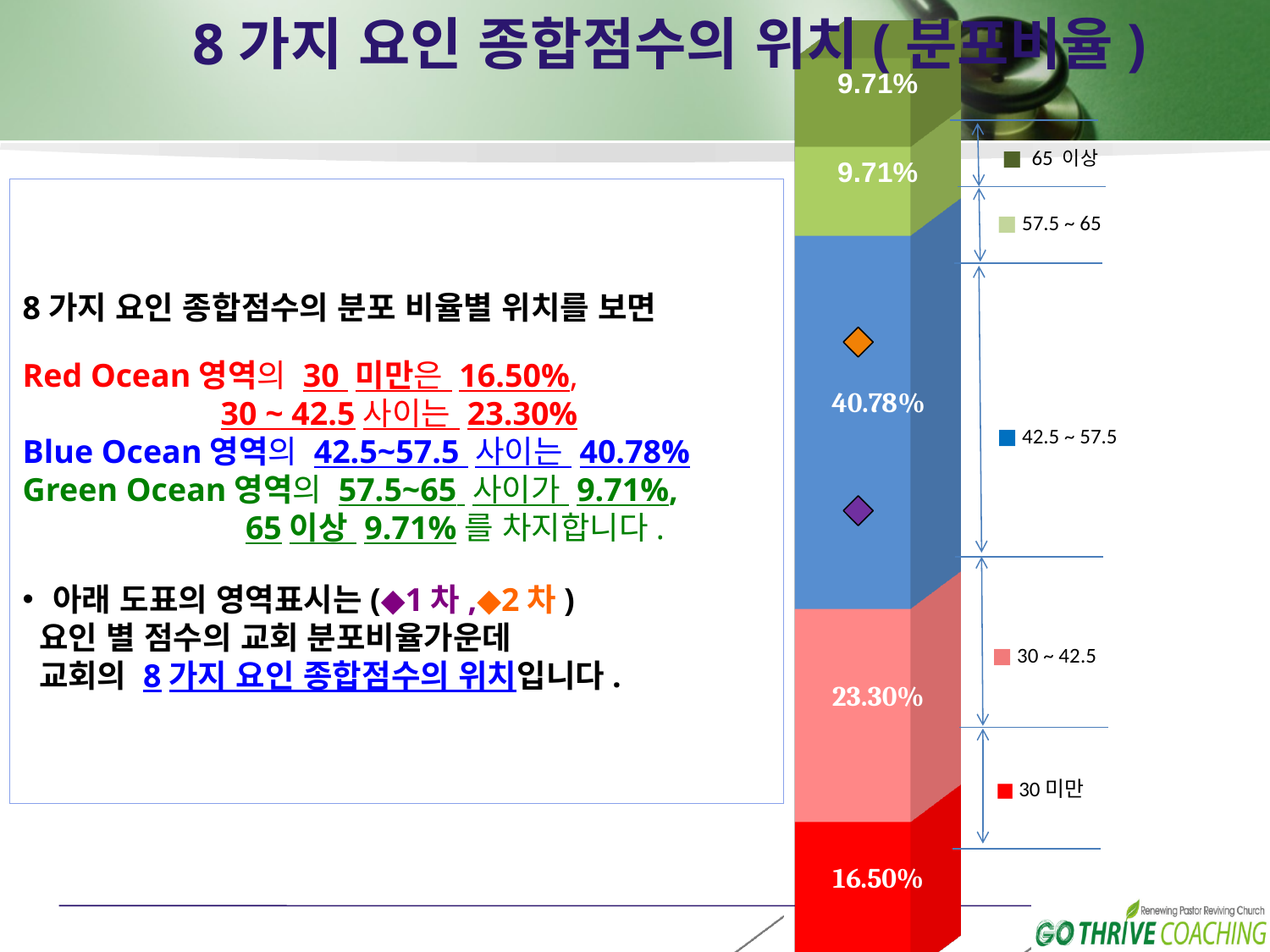
Which segment has the largest value? 42.5 ~ 57.5 What is the value for the 65 이상 segment? 9.71% Which is larger, the 30 미만 segment or the 30 ~ 42.5 segment? 30 ~ 42.5 What is the value for the 57.5 ~ 65 segment? 9.71% What is the value for the 42.5 ~ 57.5 segment? 40.78% What is the difference between the 42.5 ~ 57.5 segment and the 30 ~ 42.5 segment? 17.48% What is the value for the 30 미만 segment? 16.50% What is the difference between the 30 ~ 42.5 segment and the 30 미만 segment? 6.80% What colour is the 30 미만 segment? red How many entries does the legend list? 5 What is the value for the 30 ~ 42.5 segment? 23.30% What kind of chart is shown on the slide? stacked bar chart